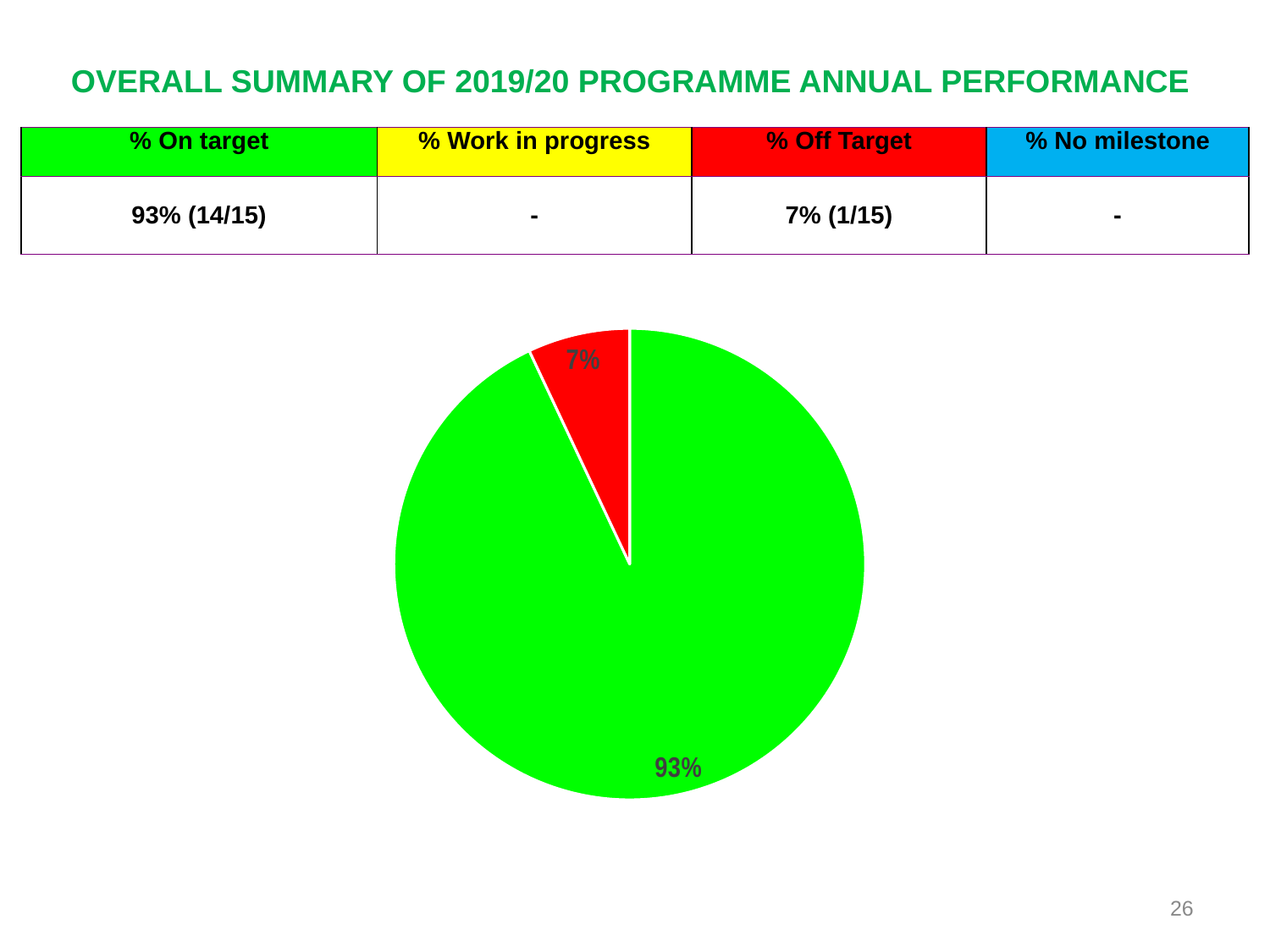
Which slice of the pie is the largest? green (93%) What kind of chart is shown on the slide? pie chart What is the difference in percentage points between the green slice and the red slice? 86 Is the share of the red slice greater or less than 10%? less What share of the pie does the green slice represent? 93% What colour is the slice labelled 93%? green Is the share of the green slice greater or less than 90%? greater What is the total of the two slice percentages shown on the pie chart? 100% How many slices does the pie chart have? 2 Which slice of the pie is the smallest? red (7%) What share of the pie does the red slice represent? 7% Which is larger, the green slice or the red slice? green slice